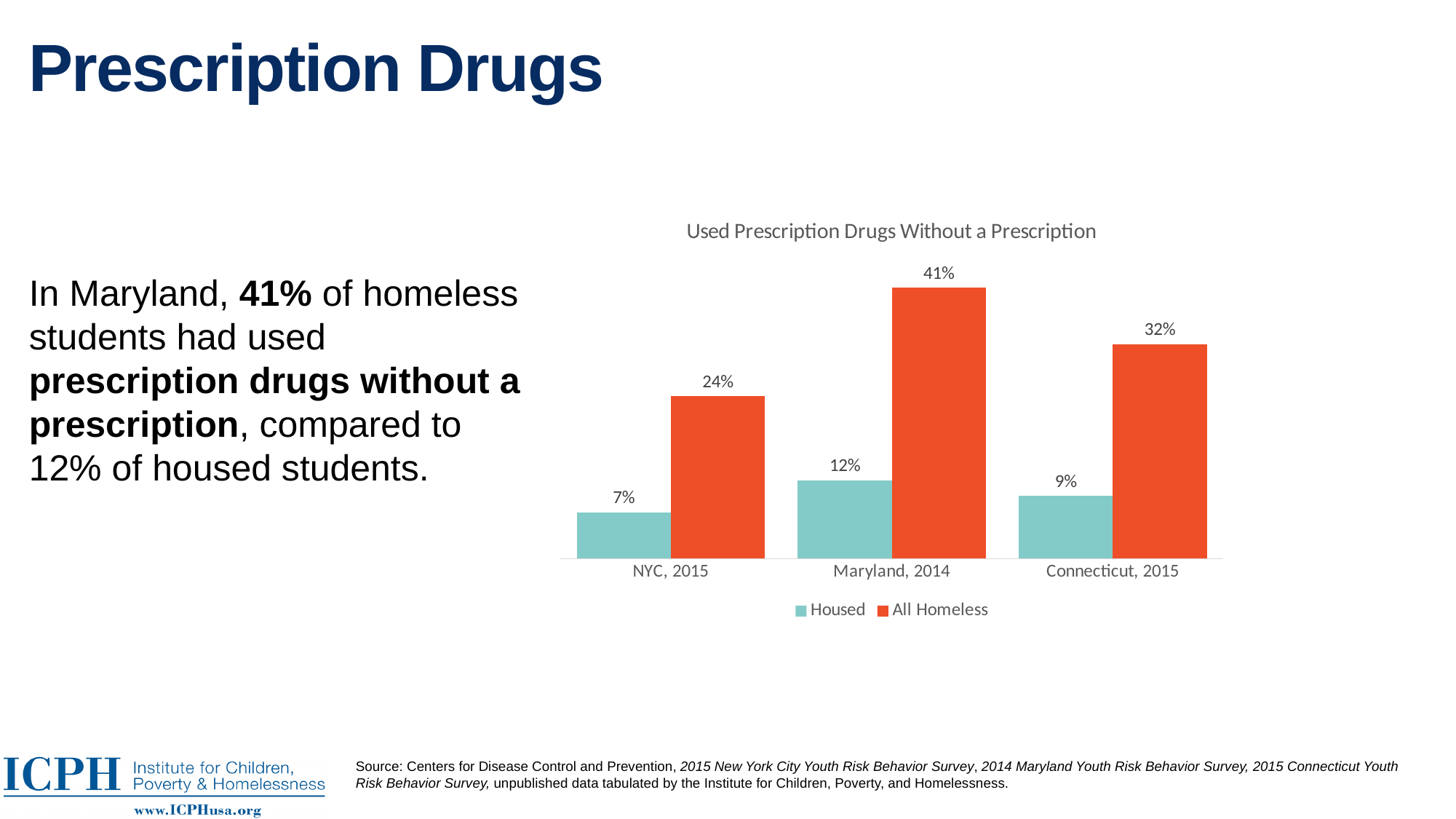
How many categories are shown on the x axis? 3 What is the value for All Homeless in Maryland, 2014? 41% What is the value for Housed in NYC, 2015? 7% What is the value for Housed in Connecticut, 2015? 9% What is the value for All Homeless in Connecticut, 2015? 32% How many series does the legend list? 2 Which is larger: the Housed value for Maryland, 2014 or the Housed value for Connecticut, 2015? Maryland, 2014 What is the difference between the All Homeless and Housed values in Maryland, 2014? 29% Which category has the highest All Homeless value? Maryland, 2014 Which category has the lowest Housed value? NYC, 2015 What is the difference between the All Homeless values for Connecticut, 2015 and NYC, 2015? 8% What is the title of the chart? Used Prescription Drugs Without a Prescription